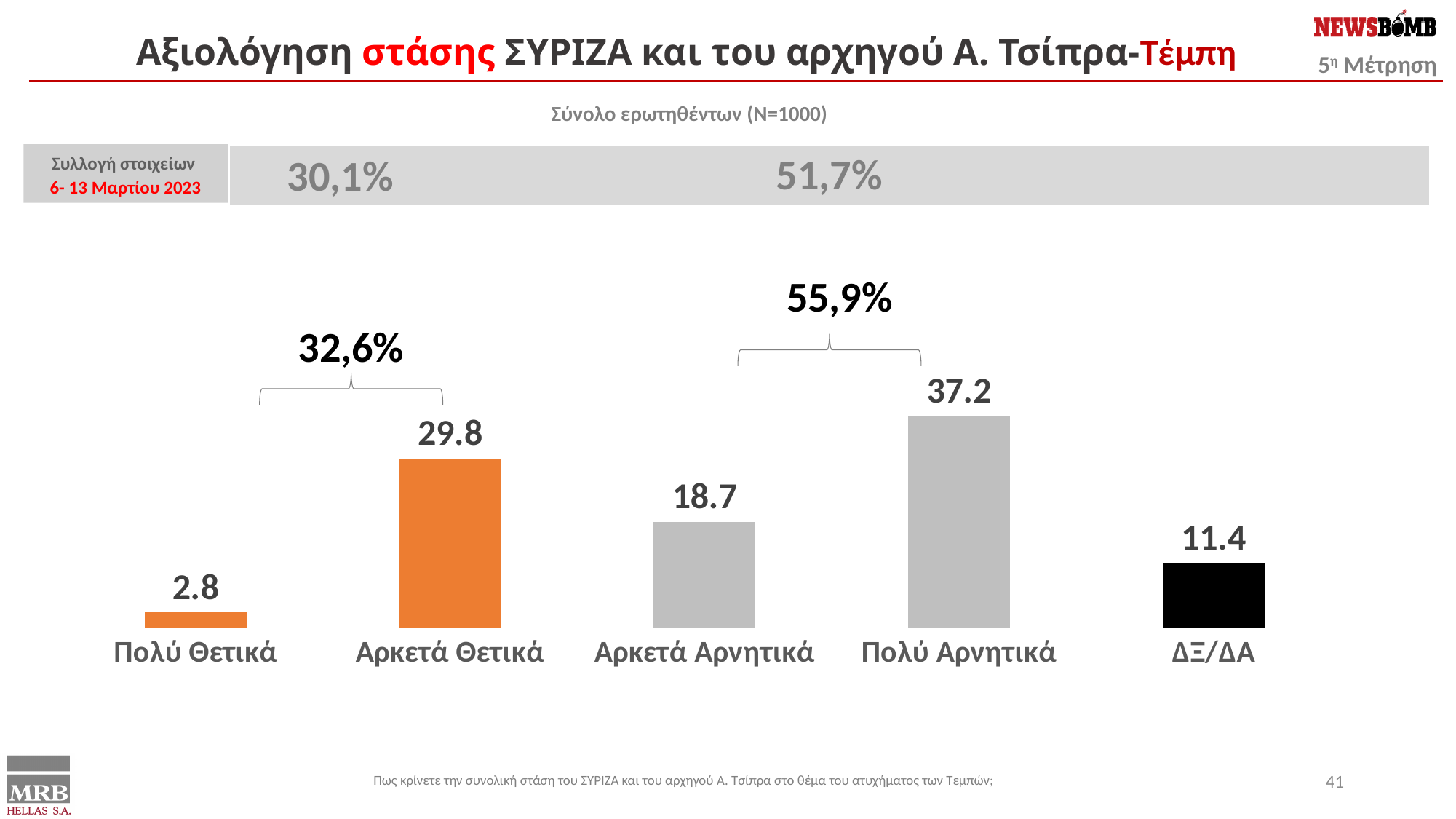
What is the value for Πολύ Θετικά? 2.8 What combined percentage is shown by the bracket above the two positive categories (Πολύ Θετικά and Αρκετά Θετικά)? 32,6% How many categories are shown in the bar chart? 5 What kind of chart is shown on the slide? Bar chart What is the value for ΔΞ/ΔΑ? 11.4 What is the value for Αρκετά Θετικά? 29.8 Which is larger, the value for Αρκετά Θετικά or the value for Αρκετά Αρνητικά? Αρκετά Θετικά What combined percentage is shown by the bracket above the two negative categories (Αρκετά Αρνητικά and Πολύ Αρνητικά)? 55,9% What is the value for Πολύ Αρνητικά? 37.2 Which category has the highest value? Πολύ Αρνητικά Which category has the lowest value? Πολύ Θετικά What is the difference between the values for Πολύ Αρνητικά and Αρκετά Αρνητικά? 18.5